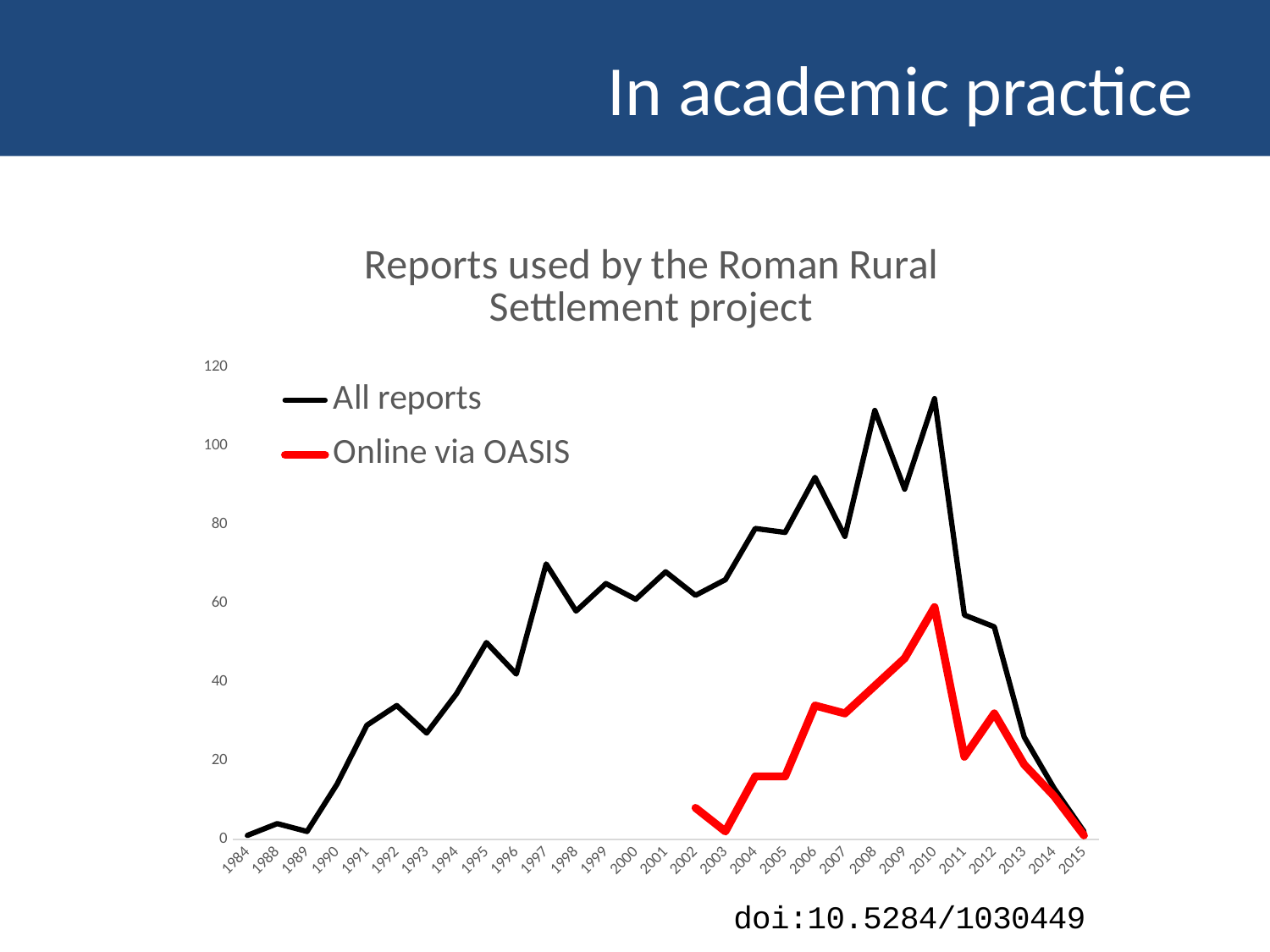
What is the title of the chart? Reports used by the Roman Rural Settlement project How many series does the legend list? 2 Is the value for Online via OASIS in 2006 greater or less than 20? greater Is the value for All reports in 1997 greater or less than 60? greater Is the value for All reports in 2010 greater or less than 100? greater Which is larger for All reports: the value in 2010 or the value in 2015? 2010 Do the All reports values rise or fall from 2010 to 2015? fall In which year does the Online via OASIS series reach its highest value? 2010 What kind of chart is shown on the slide? line chart How many years are labelled along the x axis? 29 Which series is drawn in red? Online via OASIS